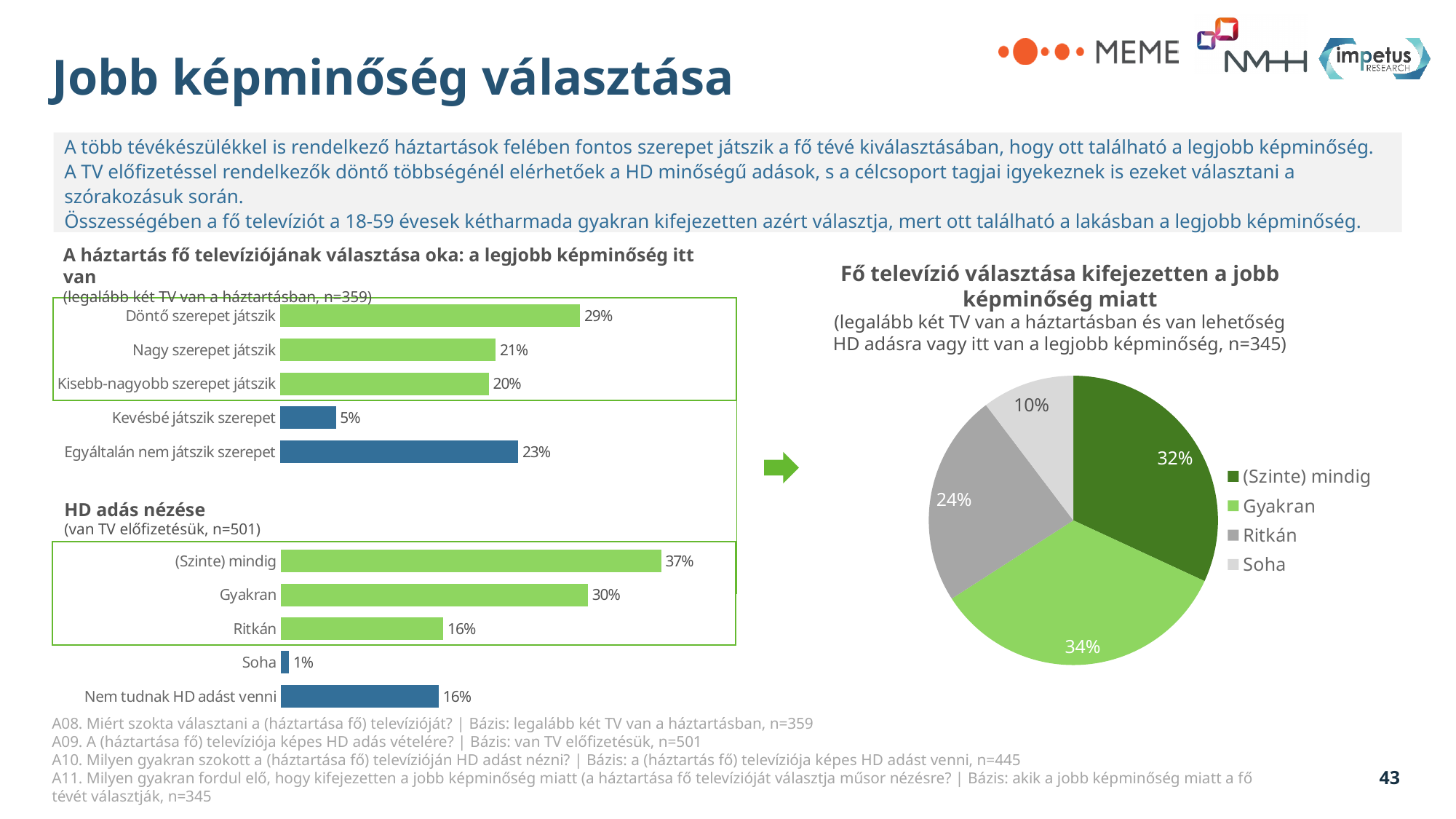
In the 'A háztartás fő televíziójának választása oka' bar chart, how many categories are shown? 5 In the 'HD adás nézése' bar chart, which category has the highest value? (Szinte) mindig In the 'HD adás nézése' bar chart, which is larger: 'Ritkán' or 'Soha'? Ritkán In the 'HD adás nézése' bar chart, what is the value for 'Gyakran'? 30% In the 'A háztartás fő televíziójának választása oka' bar chart, what is the value for 'Döntő szerepet játszik'? 29% In the pie chart 'Fő televízió választása kifejezetten a jobb képminőség miatt', what share does 'Gyakran' have? 34% In the pie chart 'Fő televízió választása kifejezetten a jobb képminőség miatt', which slice is the smallest? Soha How many entries does the legend of the pie chart 'Fő televízió választása kifejezetten a jobb képminőség miatt' list? 4 What type of chart is 'Fő televízió választása kifejezetten a jobb képminőség miatt'? Pie chart In the 'A háztartás fő televíziójának választása oka' bar chart, what is the difference between 'Döntő szerepet játszik' and 'Egyáltalán nem játszik szerepet'? 6 percentage points In the 'HD adás nézése' bar chart, what is the value for 'Nem tudnak HD adást venni'? 16% In the 'A háztartás fő televíziójának választása oka' bar chart, which category has the lowest value? Kevésbé játszik szerepet